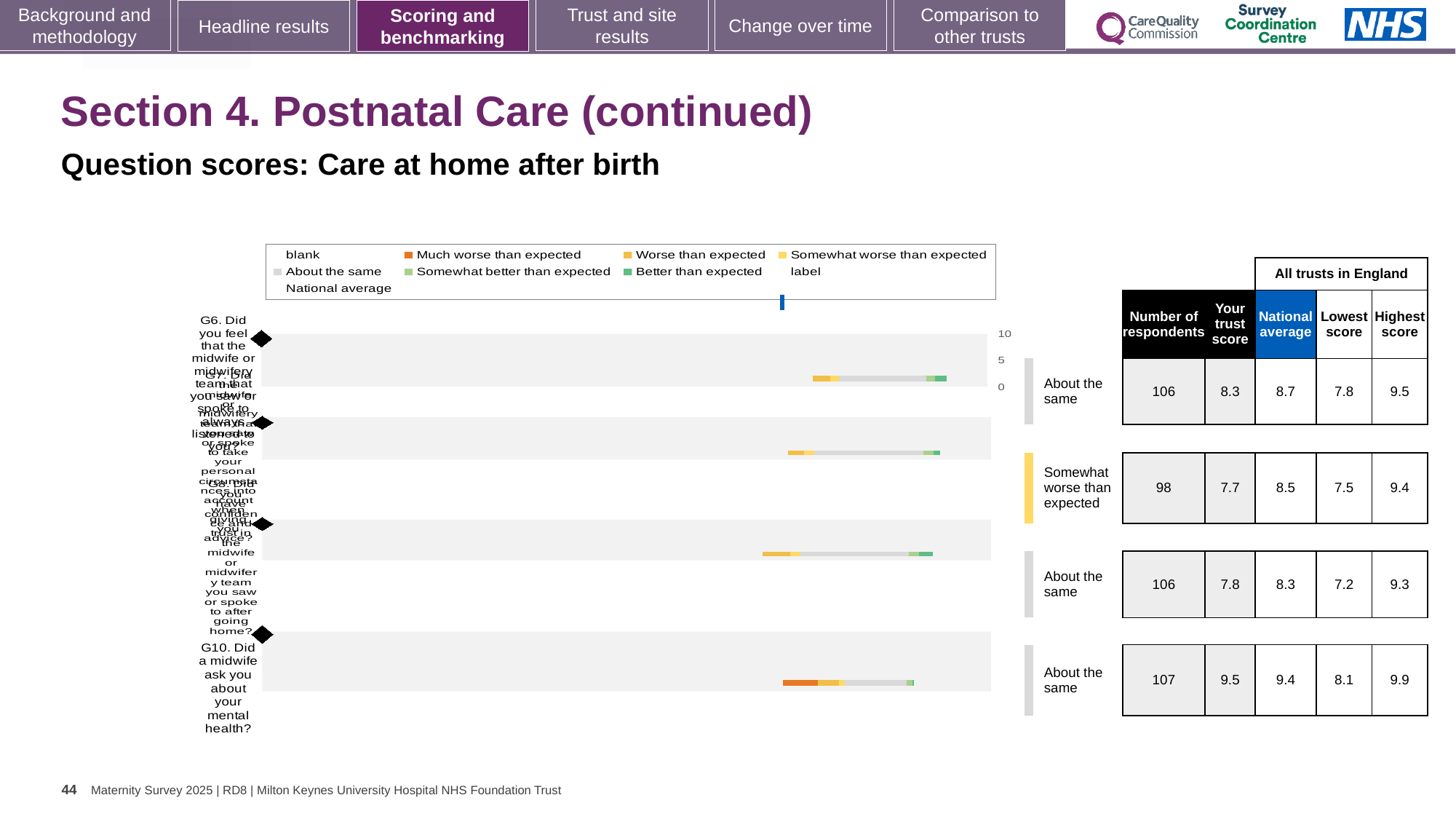
In the table beside the chart, what is the highest score for G10 (Did a midwife ask you about your mental health?)? 9.9 What colour in the legend represents 'Much worse than expected'? orange In the table beside the chart, which question has the highest trust score? G10 In the table beside the chart, is the trust score for G10 higher or lower than the national average? higher In the table beside the chart, what is the national average for G6 (Did you feel that the midwife or midwifery team listened to you?)? 8.7 In the table beside the chart, what is the number of respondents for G10 (Did a midwife ask you about your mental health?)? 107 In the table beside the chart, what is the trust score for G10 (Did a midwife ask you about your mental health?)? 9.5 What kind of chart is shown on the slide? bar chart How many survey questions (bars) are plotted in the chart? 4 In the table beside the chart, which question has the lowest trust score? G7 In the table beside the chart, what is the difference between the national average and the trust score for G6? 0.4 What benchmark category is shown for the second row (G7) in the chart? Somewhat worse than expected